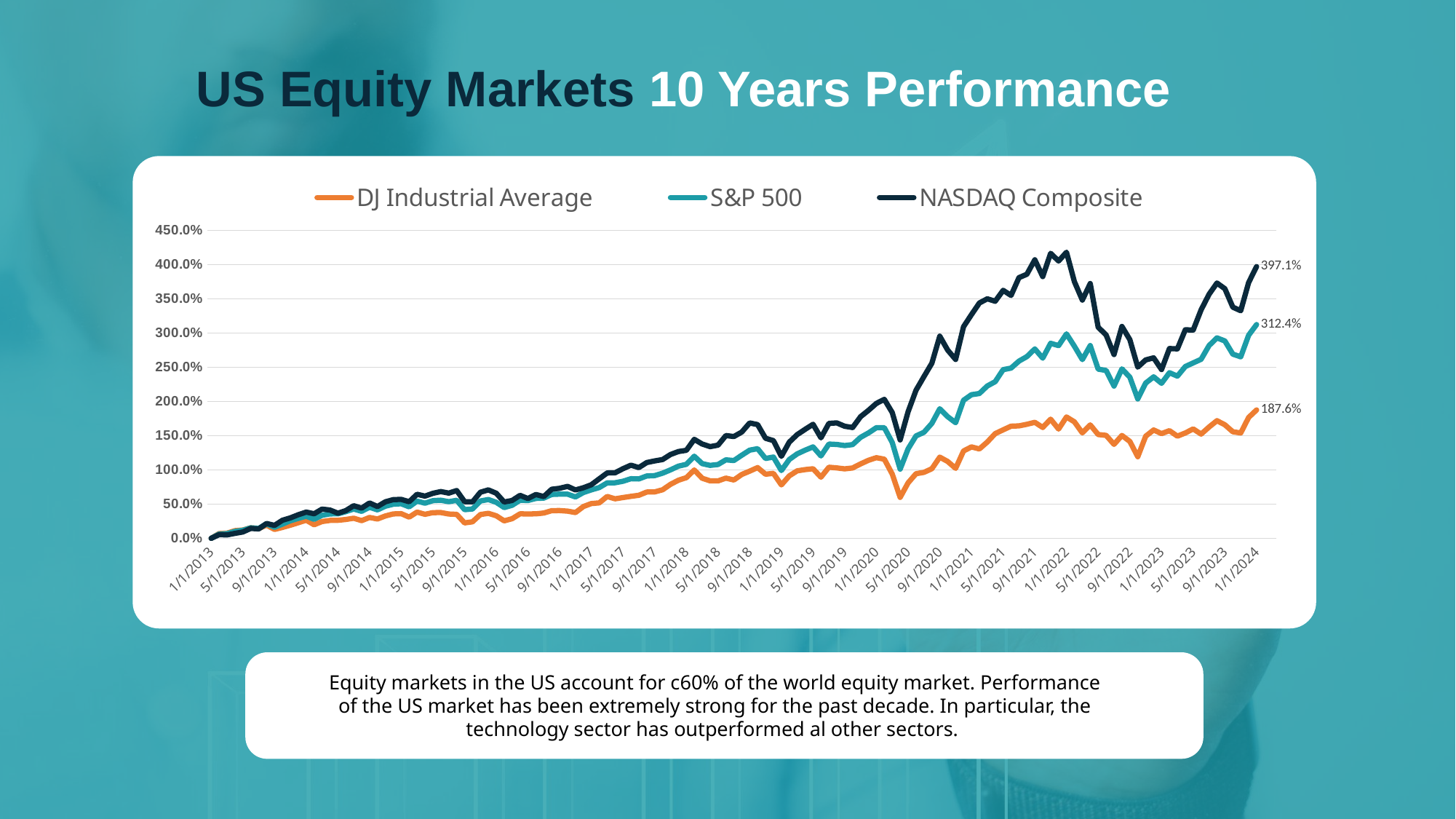
What is the final value shown for the S&P 500 at 1/1/2024? 312.4% How many series does the legend list? 3 What kind of chart is shown on the slide? Line chart Which series has the lowest value at the end of the chart? DJ Industrial Average What colour is the line for the DJ Industrial Average? Orange What is the difference between the final values of the NASDAQ Composite and the S&P 500? 84.7 percentage points What is the final value shown for the NASDAQ Composite at 1/1/2024? 397.1% Is the peak value of the NASDAQ Composite in late 2021 greater or less than 400%? greater What is the final value shown for the DJ Industrial Average at 1/1/2024? 187.6% What is the difference between the final values of the S&P 500 and the DJ Industrial Average? 124.8 percentage points Do the values of the three series generally rise or fall from 1/1/2013 to 1/1/2024? Rise Which series has the highest value at the end of the chart? NASDAQ Composite